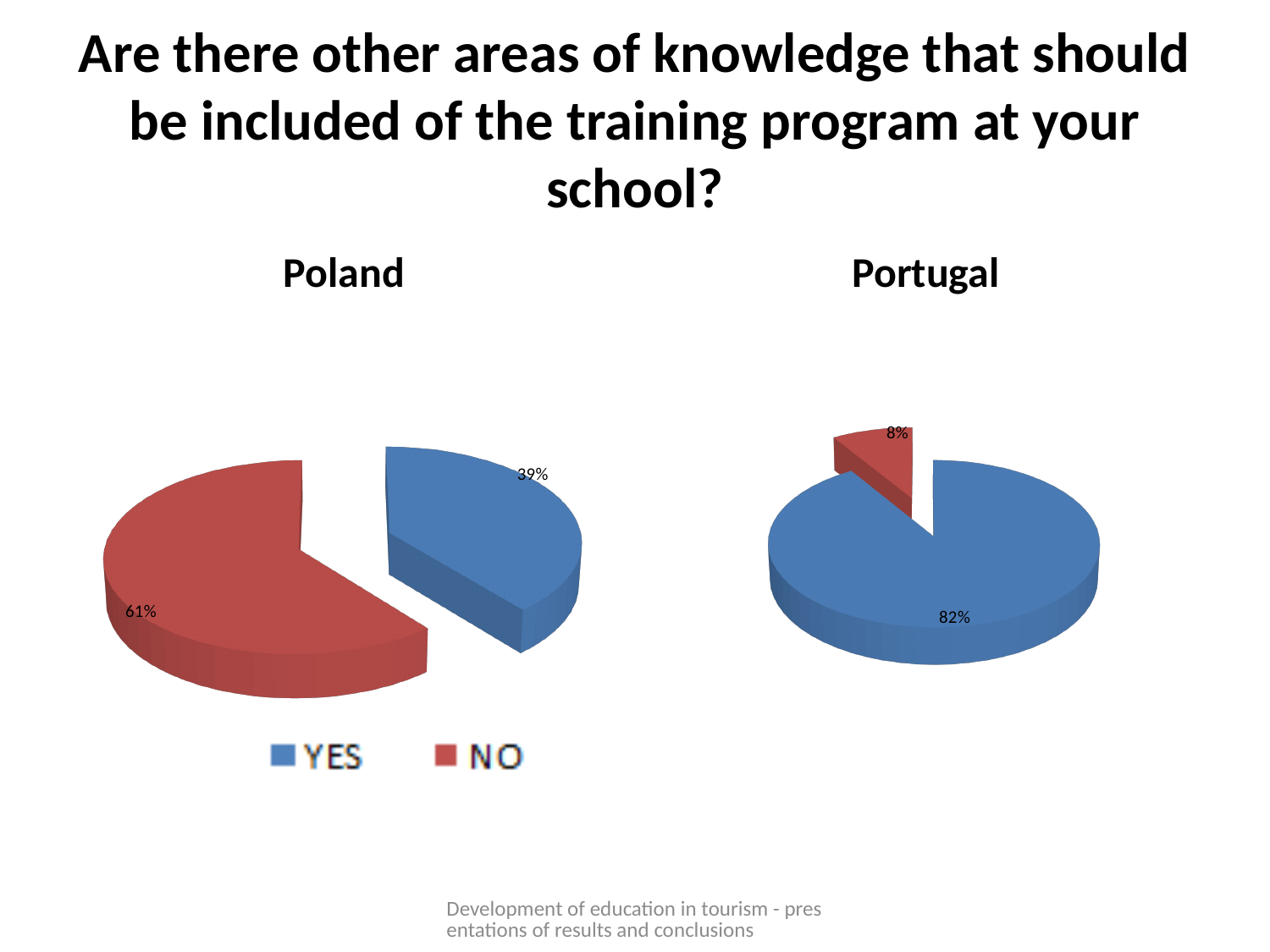
In the Poland chart, what percentage of respondents answered NO? 61% How many slices does the Poland pie chart have? 2 In the Poland chart, what is the difference in percentage points between the NO and YES shares? 22 In the Portugal chart, what is the difference in percentage points between the YES and NO shares? 74 Is the YES share larger in the Poland chart or in the Portugal chart? Portugal What type of chart is used for the Poland and Portugal data? Pie chart Which colour represents the NO answer in the legend? Red In the Portugal chart, what percentage of respondents answered NO? 8% In the Poland chart, which answer has the larger share? NO In the Portugal chart, what percentage of respondents answered YES? 82% In the Portugal chart, which answer has the smaller share? NO In the Poland chart, what percentage of respondents answered YES? 39%